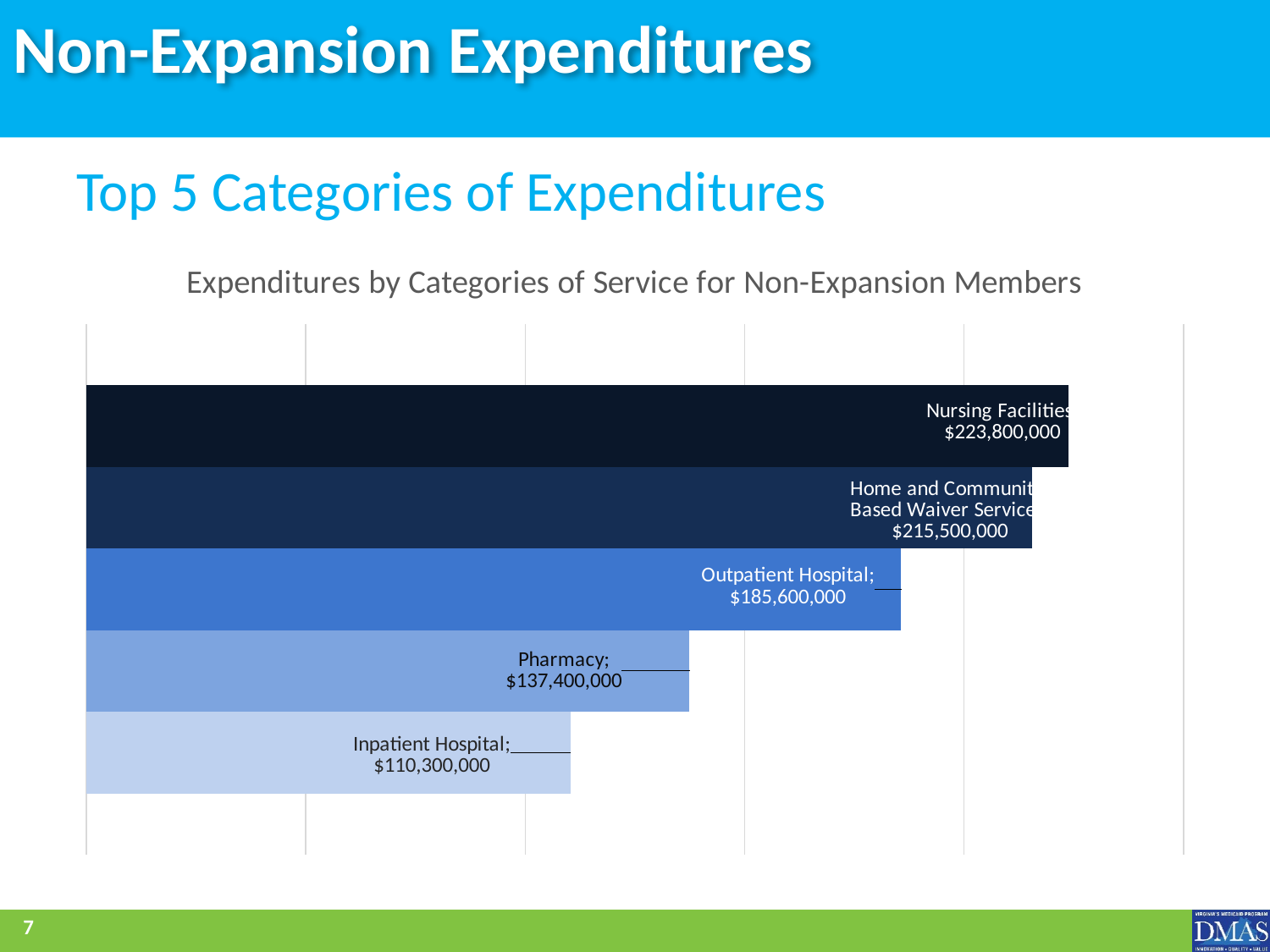
What is the difference between the Outpatient Hospital and Pharmacy expenditures? $48,200,000 Which is larger, the expenditure for Pharmacy or for Inpatient Hospital? Pharmacy Which category of service has the highest expenditure? Nursing Facilities What is the expenditure for Inpatient Hospital? $110,300,000 What is the expenditure for Nursing Facilities? $223,800,000 How many categories of service are shown in the chart? 5 What is the title of the chart? Expenditures by Categories of Service for Non-Expansion Members What is the expenditure for Outpatient Hospital? $185,600,000 What is the expenditure for Pharmacy? $137,400,000 Which category of service has the lowest expenditure? Inpatient Hospital What kind of chart is shown on the slide? Bar chart What is the difference between the Nursing Facilities and Home and Community Based Waiver Services expenditures? $8,300,000